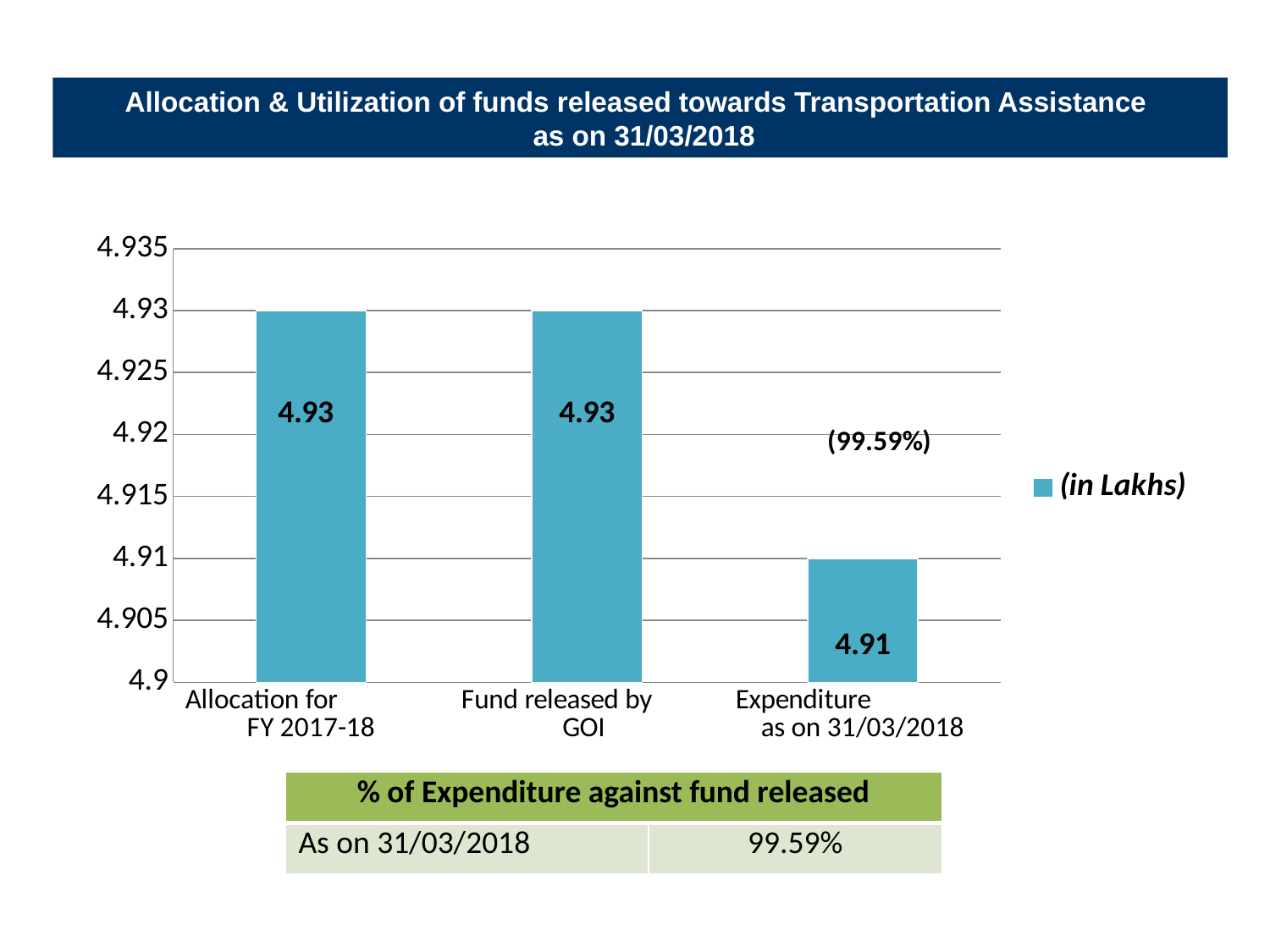
What is the difference between the value for Fund released by GOI and the value for Expenditure as on 31/03/2018? 0.02 What kind of chart is shown on the slide? bar chart Is the value for Expenditure as on 31/03/2018 greater or less than 4.92? less How many categories are shown on the x axis? 3 How many series does the legend list? 1 What is the value for Fund released by GOI? 4.93 What percentage is shown in parentheses above the Expenditure as on 31/03/2018 bar? (99.59%) What is the value for Expenditure as on 31/03/2018? 4.91 Which is larger, the value for Allocation for FY 2017-18 or the value for Expenditure as on 31/03/2018? Allocation for FY 2017-18 What is the value for Allocation for FY 2017-18? 4.93 Which category has the lowest value? Expenditure as on 31/03/2018 What is the legend entry for the series? (in Lakhs)